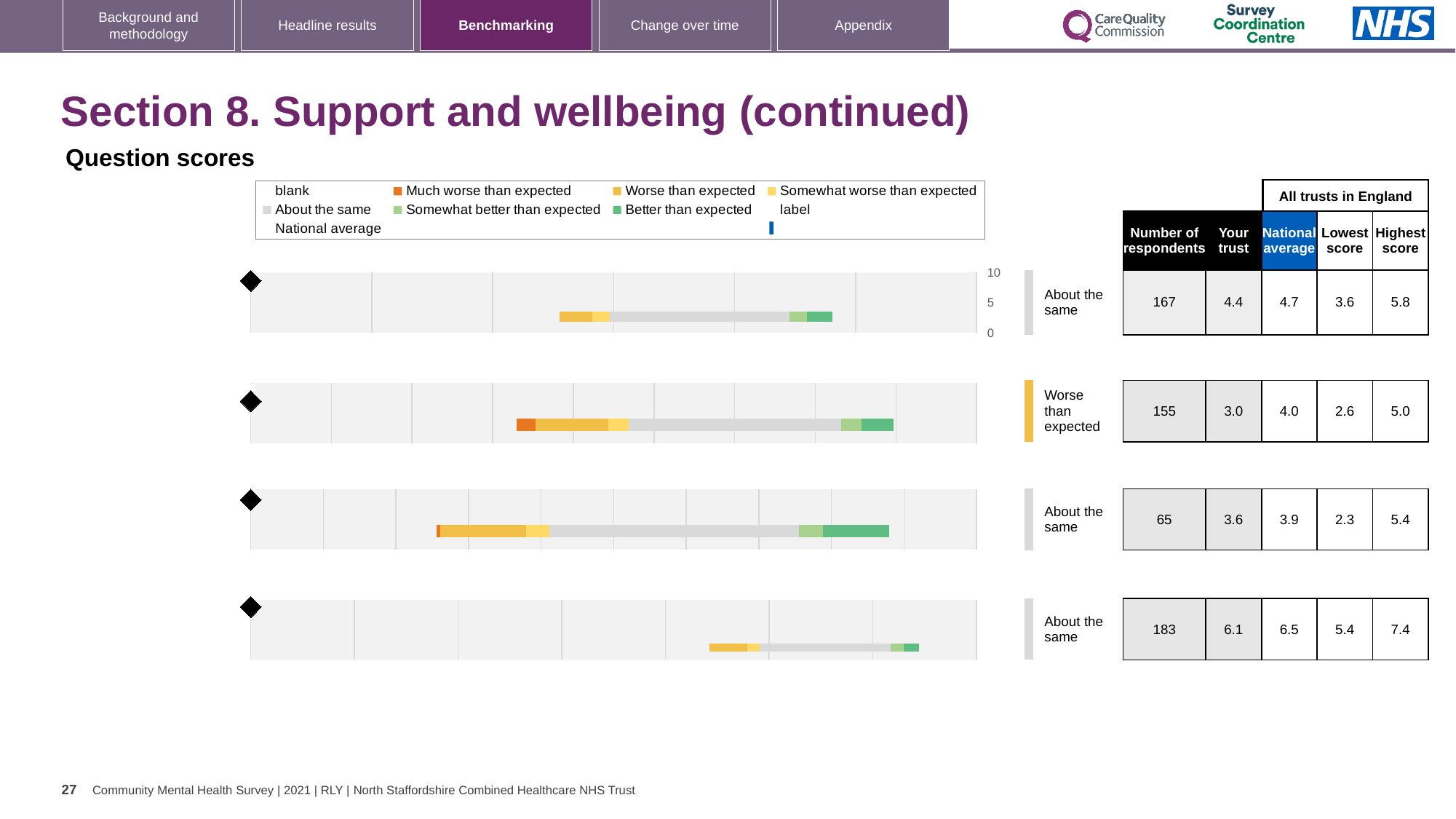
What kind of chart is used for the four benchmarking rows on the slide? bar chart For the first chart row, which is larger: the 'Your trust' score or the national average? National average How many of the four chart rows are rated 'About the same'? 3 How many benchmarking chart rows are shown on the slide? 4 In the legend, what colour represents 'Much worse than expected'? orange For the fourth (bottom) chart row, what is the national average? 6.5 For the second chart row, what is the 'Your trust' score? 3.0 Which chart row has the lowest number of respondents? the third row, 65 Which chart row has the highest 'Your trust' score? the fourth (bottom) row, 6.1 For the first (top) chart row, what is the number of respondents? 167 For the second chart row, what is the difference between the national average and the 'Your trust' score? 1.0 For the third chart row, what is the highest score among all trusts in England? 5.4